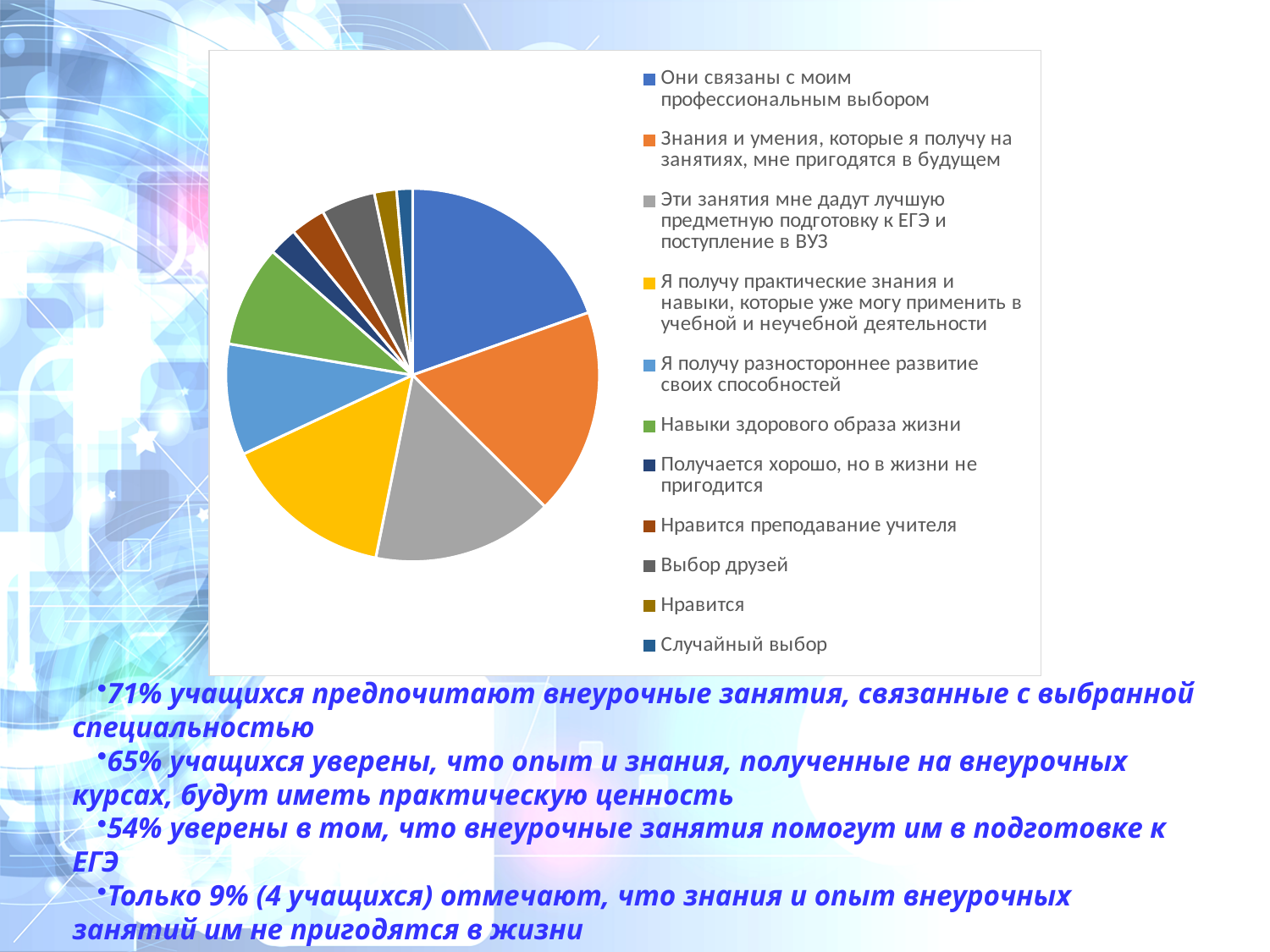
How many entries does the legend of the pie chart list? 11 Which slice is larger: "Они связаны с моим профессиональным выбором" or "Нравится преподавание учителя"? Они связаны с моим профессиональным выбором Which slice is larger: "Я получу практические знания и навыки, которые уже могу применить в учебной и неучебной деятельности" or "Навыки здорового образа жизни"? Я получу практические знания и навыки, которые уже могу применить в учебной и неучебной деятельности How many categories (slices) does the pie chart have? 11 What colour is the slice for "Навыки здорового образа жизни" in the pie chart? green Which slice is larger: "Эти занятия мне дадут лучшую предметную подготовку к ЕГЭ и поступление в ВУЗ" or "Получается хорошо, но в жизни не пригодится"? Эти занятия мне дадут лучшую предметную подготовку к ЕГЭ и поступление в ВУЗ What kind of chart is shown on the slide? pie chart